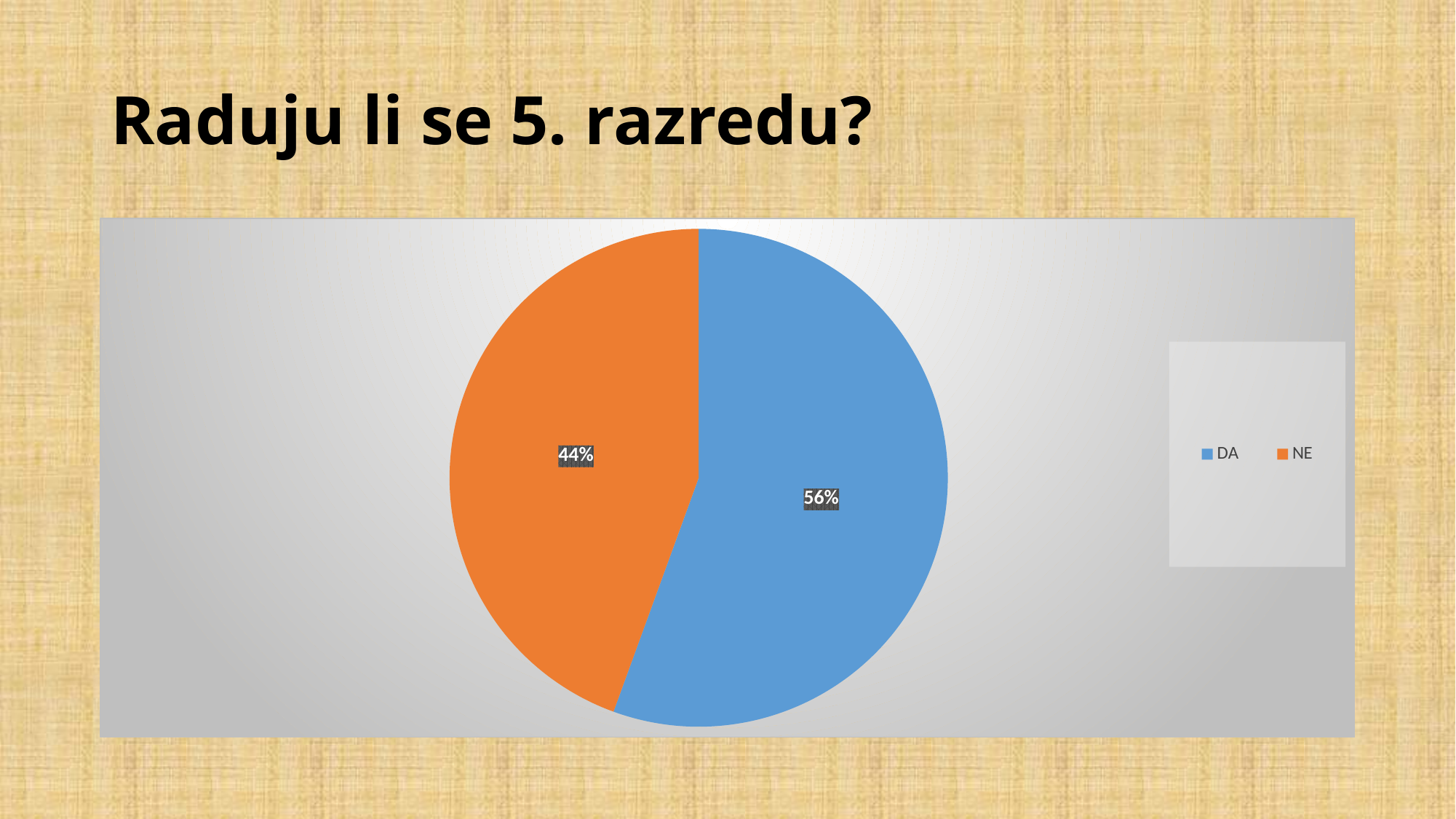
What percentage of the pie is labelled DA? 56% What is the title of the slide above the chart? Raduju li se 5. razredu? What percentage of the pie is labelled NE? 44% What share of the pie does the NE slice represent? 44% Which slice is larger, DA or NE? DA What kind of chart is shown on the slide? pie chart Which slice is the smallest in the pie chart? NE What colour is the DA slice in the pie chart? blue How many slices does the pie chart have? 2 Which slice is the largest in the pie chart? DA How many entries does the legend list? 2 What is the difference in percentage points between the DA and NE slices? 12